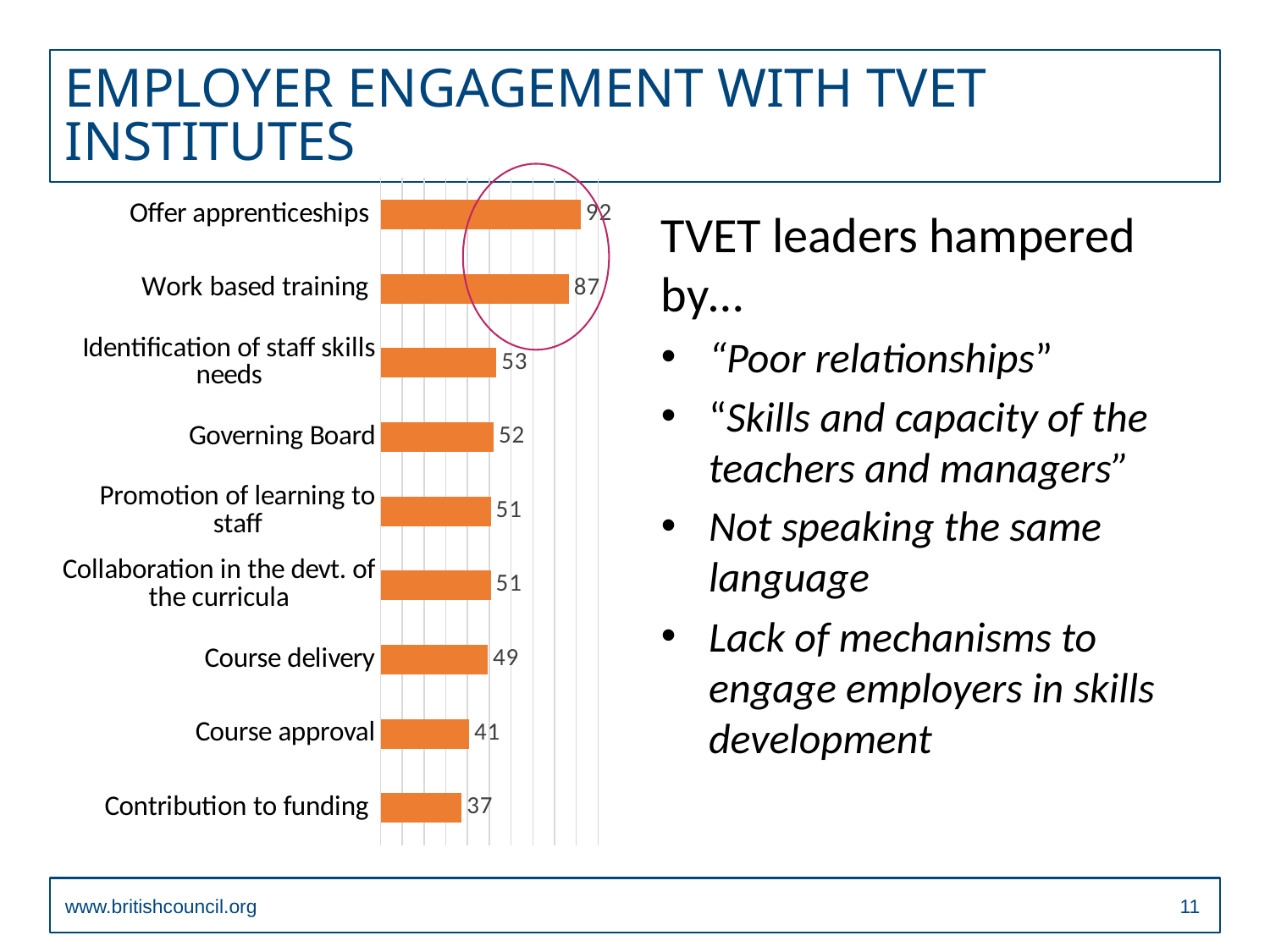
How many categories are shown in the chart? 9 What is the value for Contribution to funding? 37 What is the value for Offer apprenticeships? 92 What kind of chart is shown on the slide? Bar chart Which category has the highest value? Offer apprenticeships Which is larger, the value for Identification of staff skills needs or the value for Course delivery? Identification of staff skills needs What is the difference between the values for Course delivery and Course approval? 8 What is the value for Course approval? 41 What is the value for Work based training? 87 What is the value for Governing Board? 52 What is the difference between the values for Offer apprenticeships and Work based training? 5 Which category has the lowest value? Contribution to funding